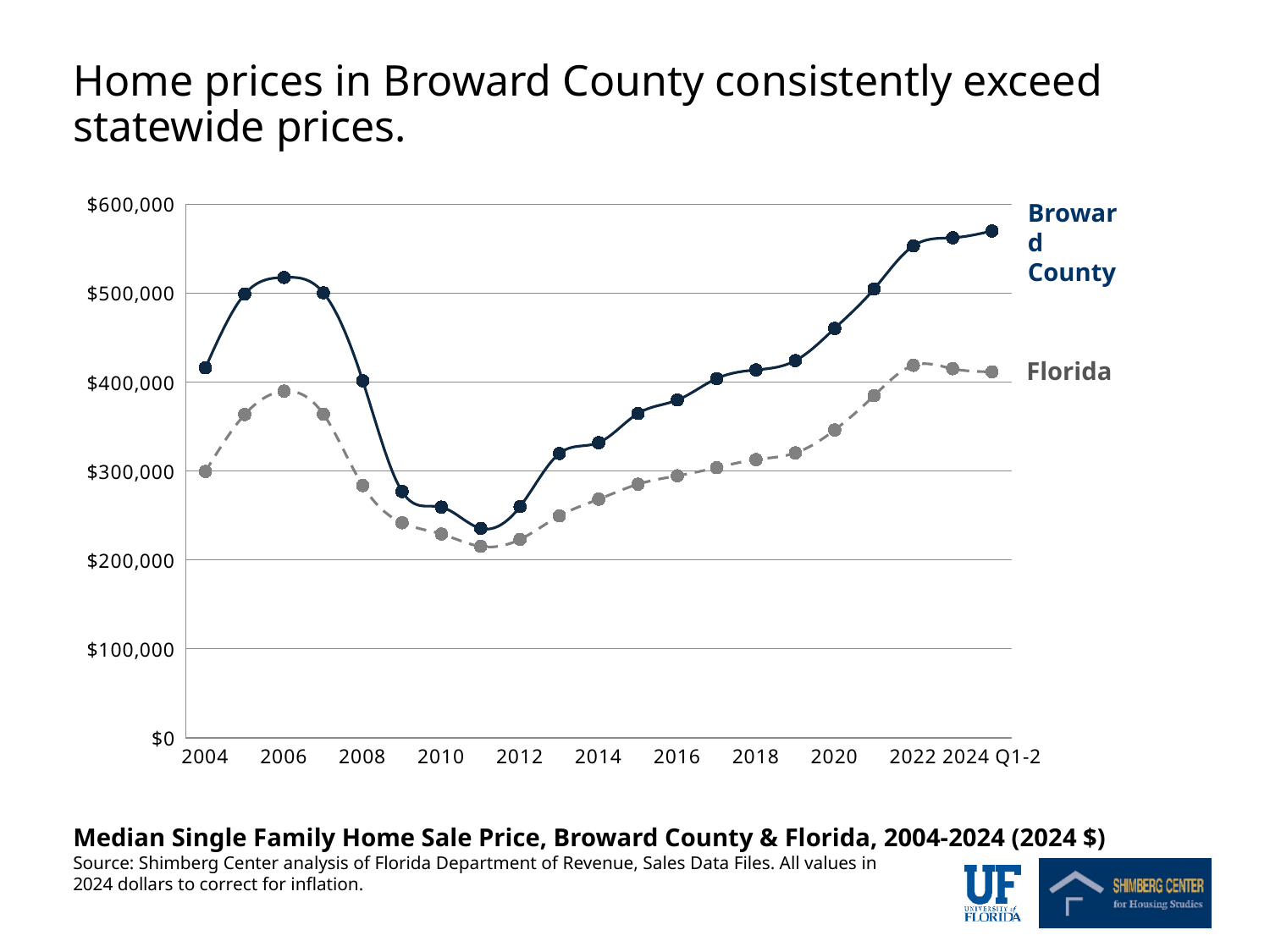
What is the title of the chart? Median Single Family Home Sale Price, Broward County & Florida, 2004-2024 (2024 $) In which year does the Broward County series reach its highest value? 2024 Q1-2 Does the Broward County series rise or fall between 2006 and 2011? Fall Which two series are plotted on the chart? Broward County and Florida Is the Florida value for 2011 greater or less than $300,000? less What kind of chart is shown on the slide? Line chart Is the Broward County value for 2006 greater or less than $500,000? greater Is the Broward County value for 2011 greater or less than $200,000? greater In which year does the Broward County series reach its lowest value? 2011 In 2016, which series has the higher value, Broward County or Florida? Broward County How many series does the chart show? 2